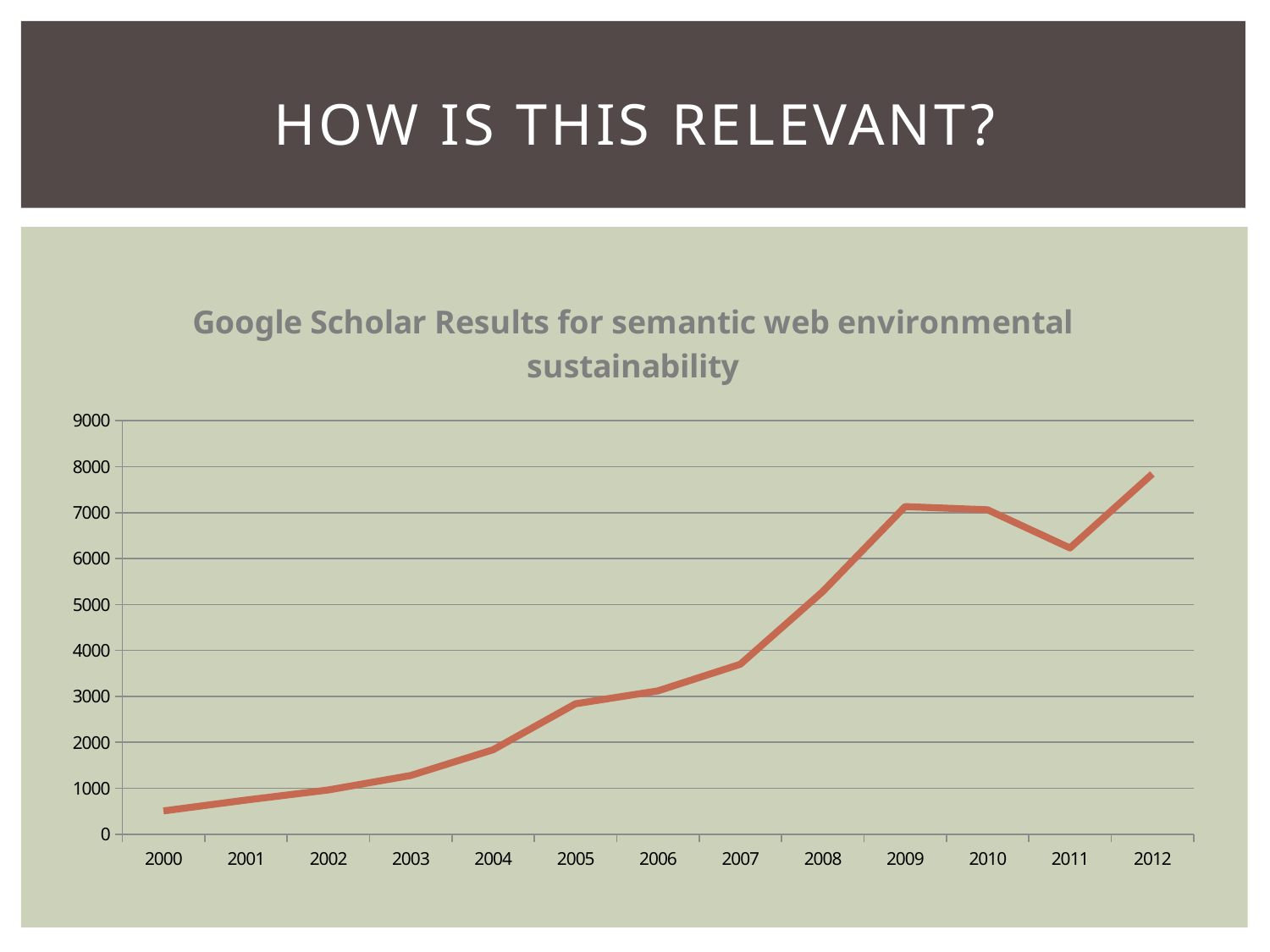
Which is larger, the value for 2007 or the value for 2008? 2008 Which is larger, the value for 2011 or the value for 2012? 2012 Is the value for 2011 greater or less than 6000? greater Which year has the lowest value? 2000 Overall, do the values rise or fall from 2000 to 2012? rise How many years are plotted along the x axis? 13 Which year has the highest value? 2012 What kind of chart is shown on the slide? line chart Is the value for 2008 greater or less than 5000? greater What is the title of the chart? Google Scholar Results for semantic web environmental sustainability